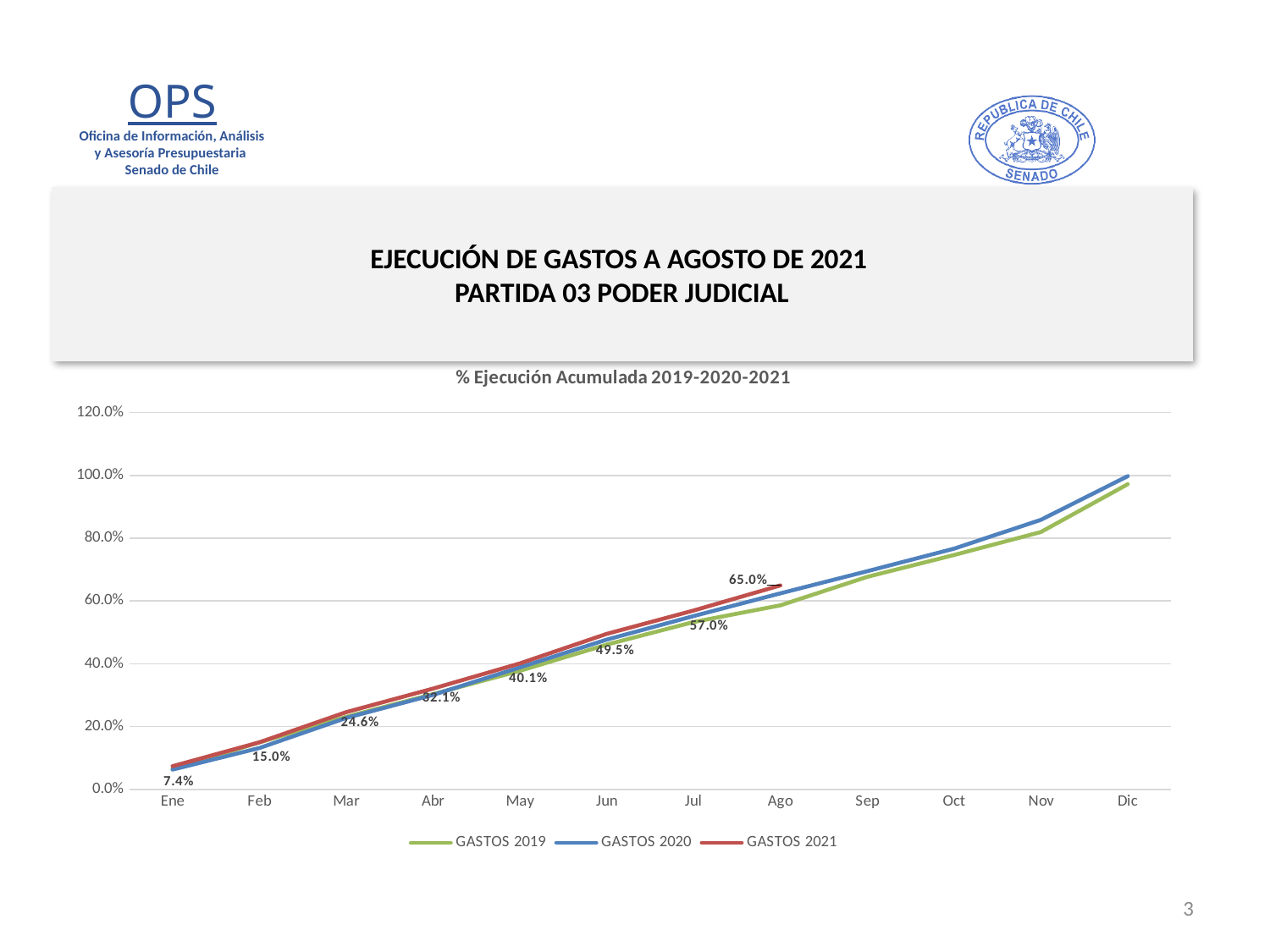
What is the difference between the GASTOS 2021 values for Ago and Jul? 8.0% What is the value for GASTOS 2021 in Ago? 65.0% How many months are shown on the x axis? 12 What is the value for GASTOS 2021 in Jul? 57.0% Do the GASTOS 2021 values rise or fall from Ene to Ago? rise Is the value for GASTOS 2020 in Oct greater or less than 60.0%? greater What is the value for GASTOS 2021 in Abr? 32.1% How many series does the legend list? 3 What is the title of the chart? % Ejecución Acumulada 2019-2020-2021 In which month does GASTOS 2021 reach its highest labelled value? Ago What kind of chart is shown on the slide? line chart What is the value for GASTOS 2021 in Ene? 7.4%